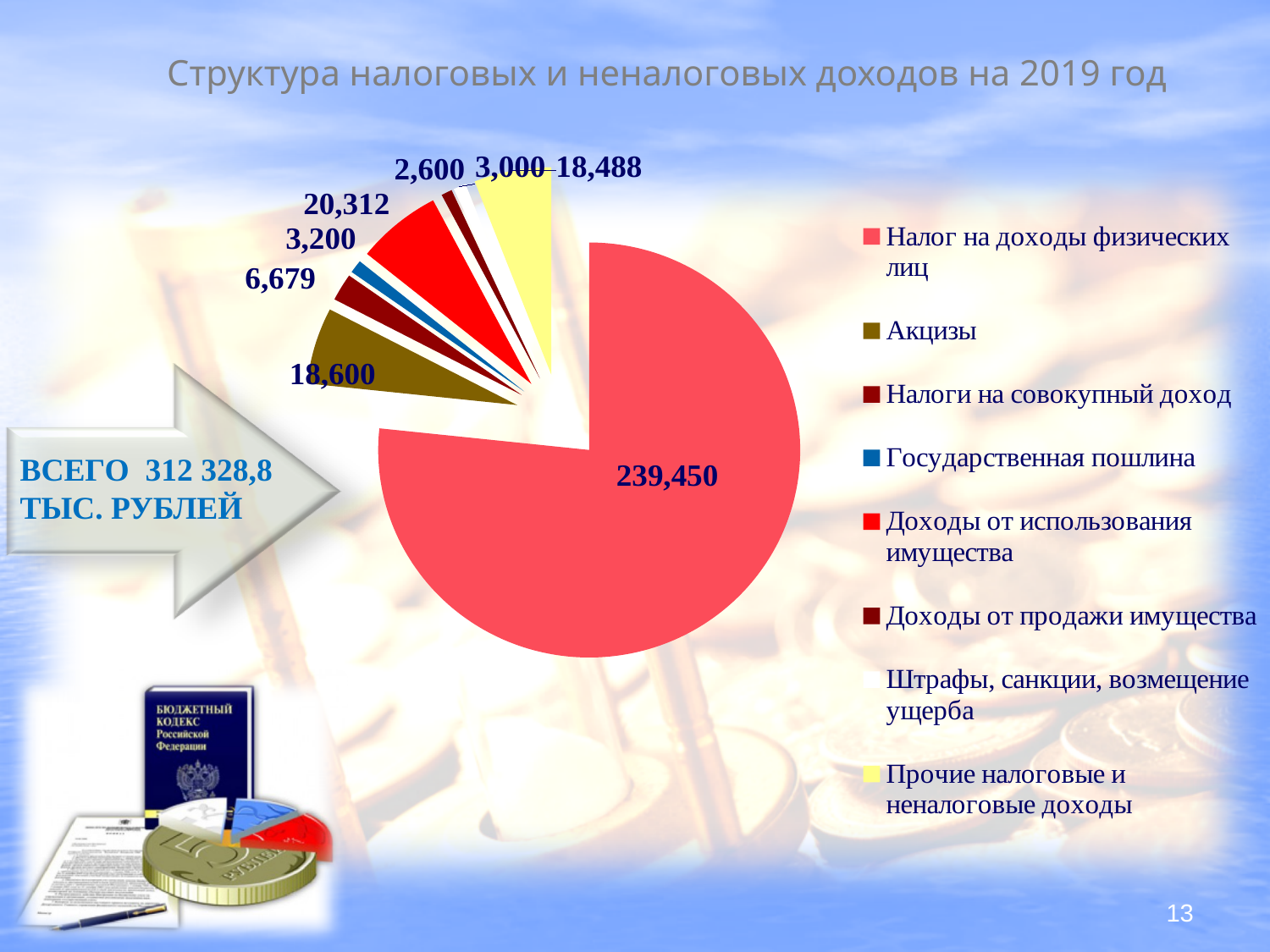
What is the value of the slice for Прочие налоговые и неналоговые доходы? 18,488 Which category has the largest slice of the pie? Налог на доходы физических лиц What is the title of the slide? Структура налоговых и неналоговых доходов на 2019 год What is the value of the slice for Государственная пошлина? 3,200 Which is larger: Акцизы or Доходы от использования имущества? Доходы от использования имущества Which category has the smallest slice of the pie? Доходы от продажи имущества How many categories does the legend list? 8 What type of chart is shown on the slide? pie chart What is the difference between the values for Доходы от использования имущества and Акцизы? 1,712 What is the value of the slice for Налог на доходы физических лиц? 239,450 What is the value of the slice for Акцизы? 18,600 What is the value of the slice for Доходы от использования имущества? 20,312